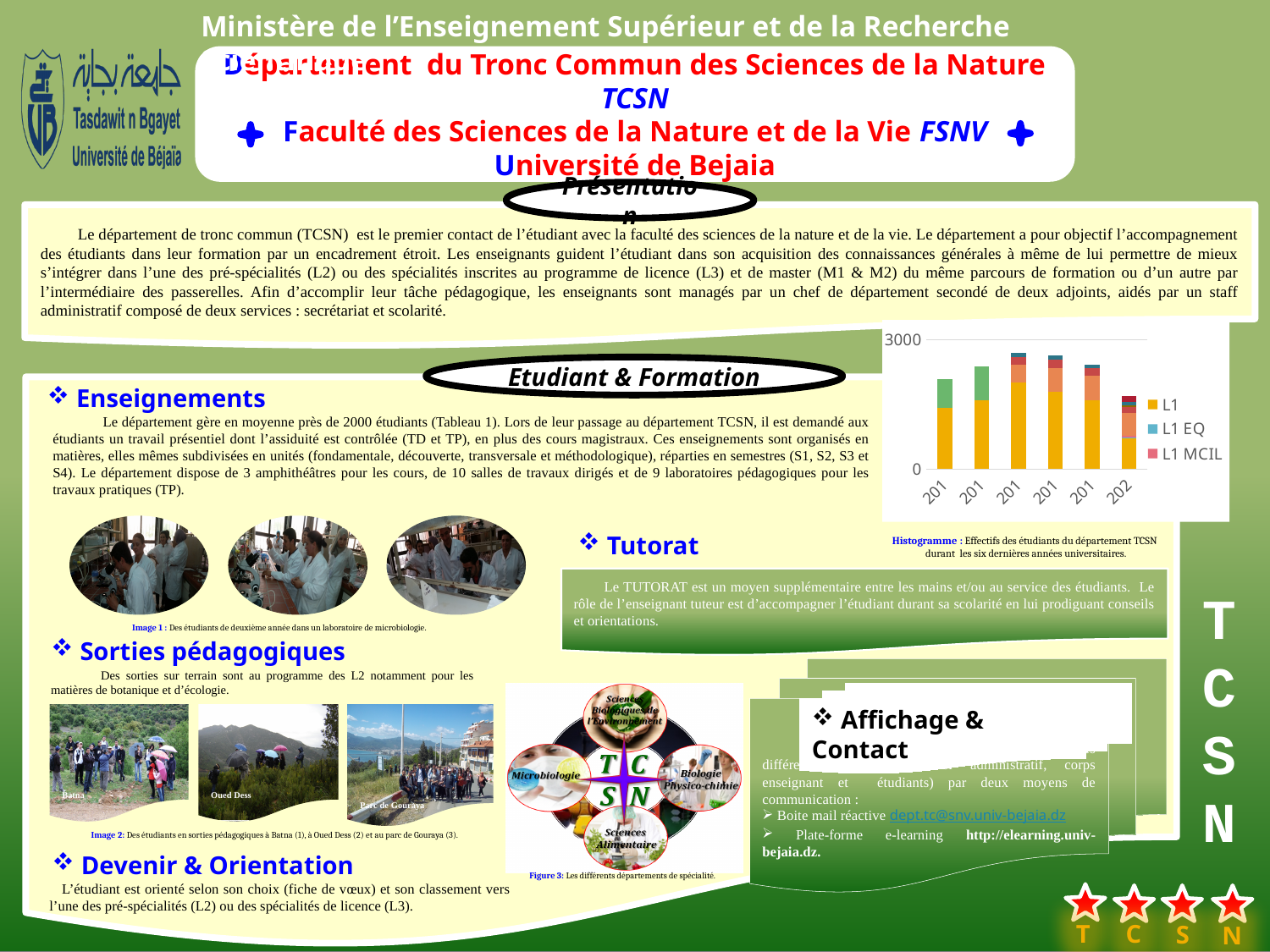
Is the value of the rightmost bar in the chart greater or less than 3000? less Is the value of the tallest bar in the chart greater or less than 3000? less What is the highest value labelled on the vertical axis of the chart? 3000 Is the rightmost bar in the chart taller or shorter than the leftmost bar? shorter How many bars does the chart on the slide contain? 6 Is the second bar from the left taller or shorter than the first bar? taller Which bar in the chart is the shortest? the rightmost (sixth) bar Which bar in the chart is the tallest? the third bar from the left What kind of chart is shown on the slide? bar chart Which series forms the bottom (orange) segment of each stacked bar? L1